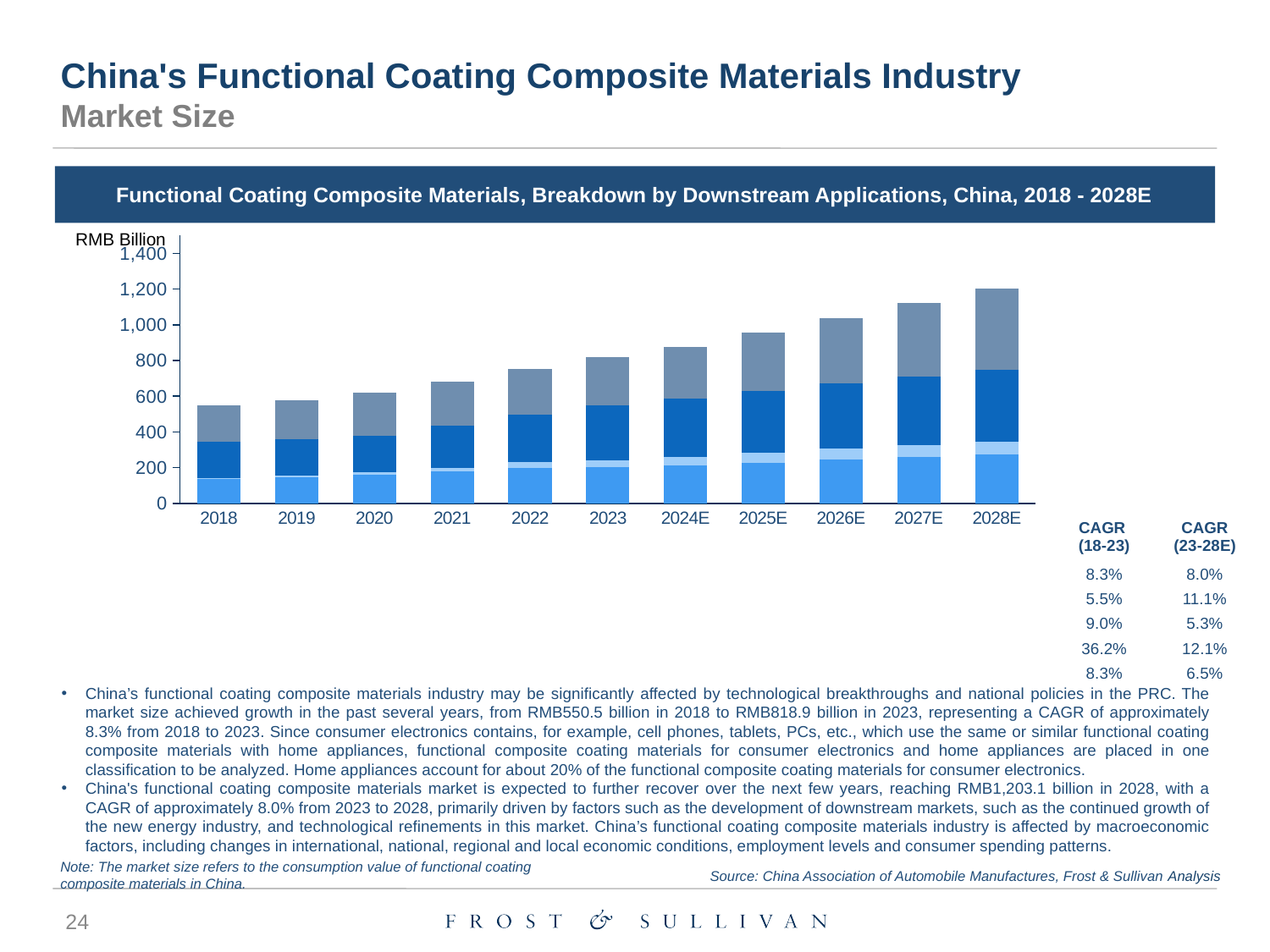
What kind of chart is shown on the slide? Stacked bar chart Which year has the shortest bar in the chart? 2018 Is the total value for 2018 greater or less than 600? less What unit is shown on the y axis of the chart? RMB Billion Is the total value for 2022 greater or less than 800? less Which bar is taller, 2023 or 2026E? 2026E Do the total bar heights rise or fall from 2018 to 2028E? Rise Is the total value for 2024E greater or less than 800? greater How many years (categories) are shown on the x axis of the chart? 11 Which year has the tallest bar in the chart? 2028E